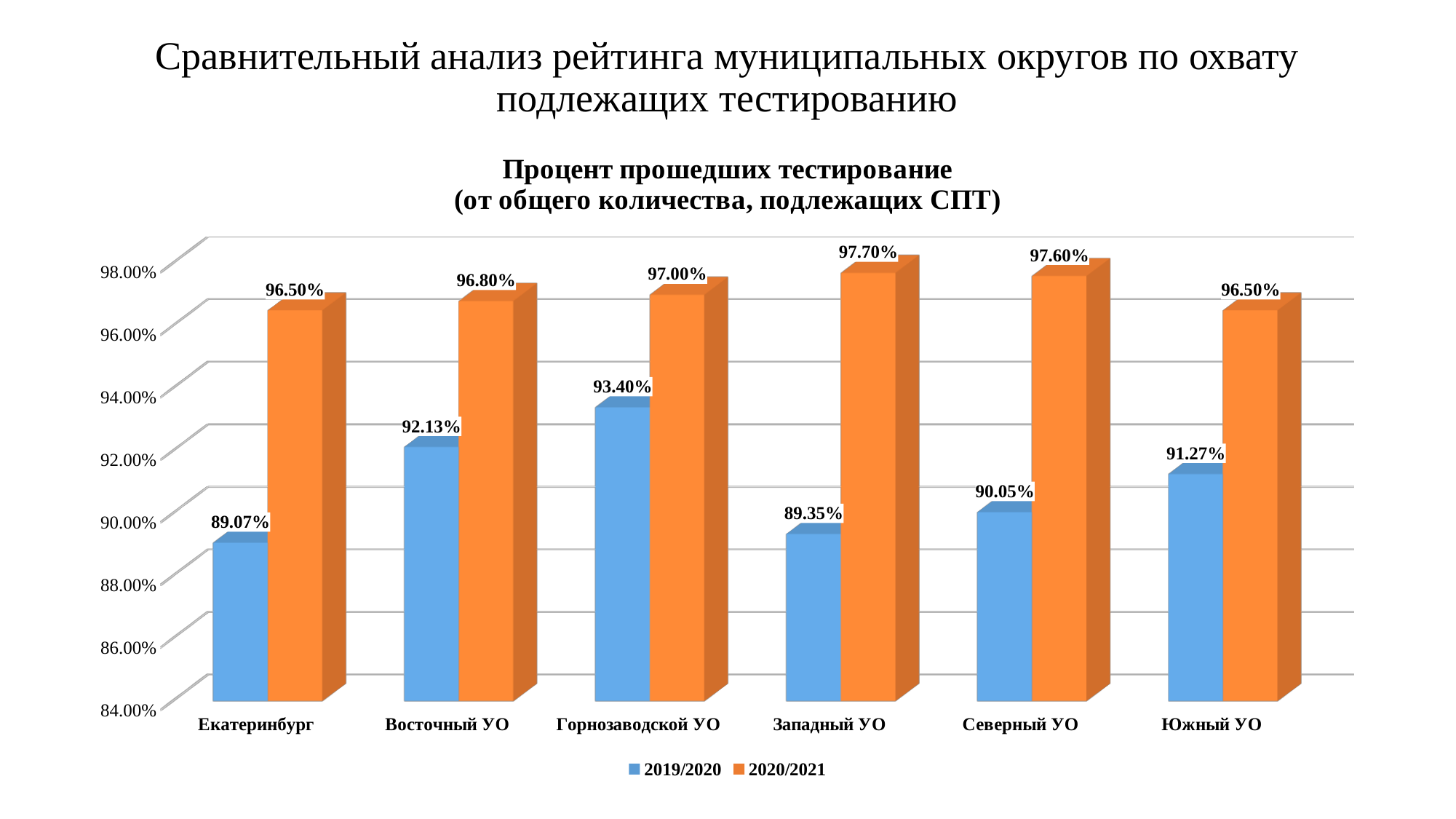
What is the value for Западный УО in the 2020/2021 series? 97.70% What is the difference between the 2020/2021 and 2019/2020 values for Екатеринбург? 7.43% What is the title of the chart? Процент прошедших тестирование (от общего количества, подлежащих СПТ) How many series does the legend list? 2 What is the value for Екатеринбург in the 2019/2020 series? 89.07% Which category has the highest value in the 2020/2021 series? Западный УО What type of chart is shown on the slide? bar chart Which category has the lowest value in the 2019/2020 series? Екатеринбург What is the value for Южный УО in the 2019/2020 series? 91.27% Which category has the highest value in the 2019/2020 series? Горнозаводской УО How many categories (districts) are shown on the x axis? 6 Which is larger: the 2019/2020 value for Восточный УО or the 2019/2020 value for Северный УО? Восточный УО